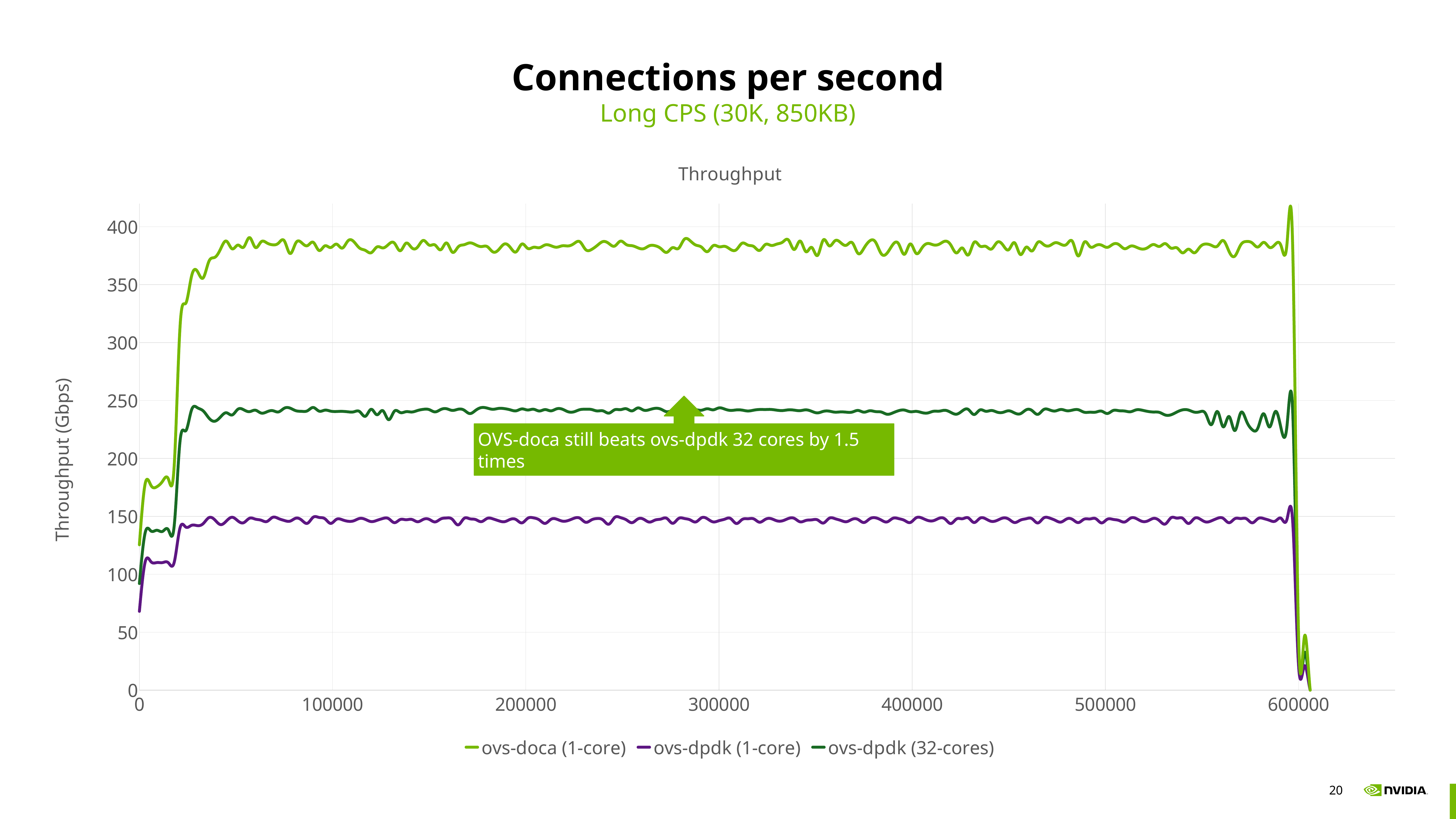
Is the value for ovs-dpdk (32-cores) at x = 400000 greater or less than 300? less Which series has the highest throughput across most of the x axis? ovs-doca (1-core) At x = 300000, which is larger: ovs-dpdk (32-cores) or ovs-dpdk (1-core)? ovs-dpdk (32-cores) Is the value for ovs-doca (1-core) at x = 300000 greater or less than 350? greater Which series has the lowest throughput across most of the x axis? ovs-dpdk (1-core) What kind of chart is shown on the slide? line chart What is the label of the y axis? Throughput (Gbps) Is the value for ovs-dpdk (1-core) at x = 300000 greater or less than 200? less What is the title shown directly above the chart? Throughput Between x = 100000 and x = 500000, does the ovs-doca (1-core) line rise, fall, or stay roughly flat? roughly flat How many series does the legend list? 3